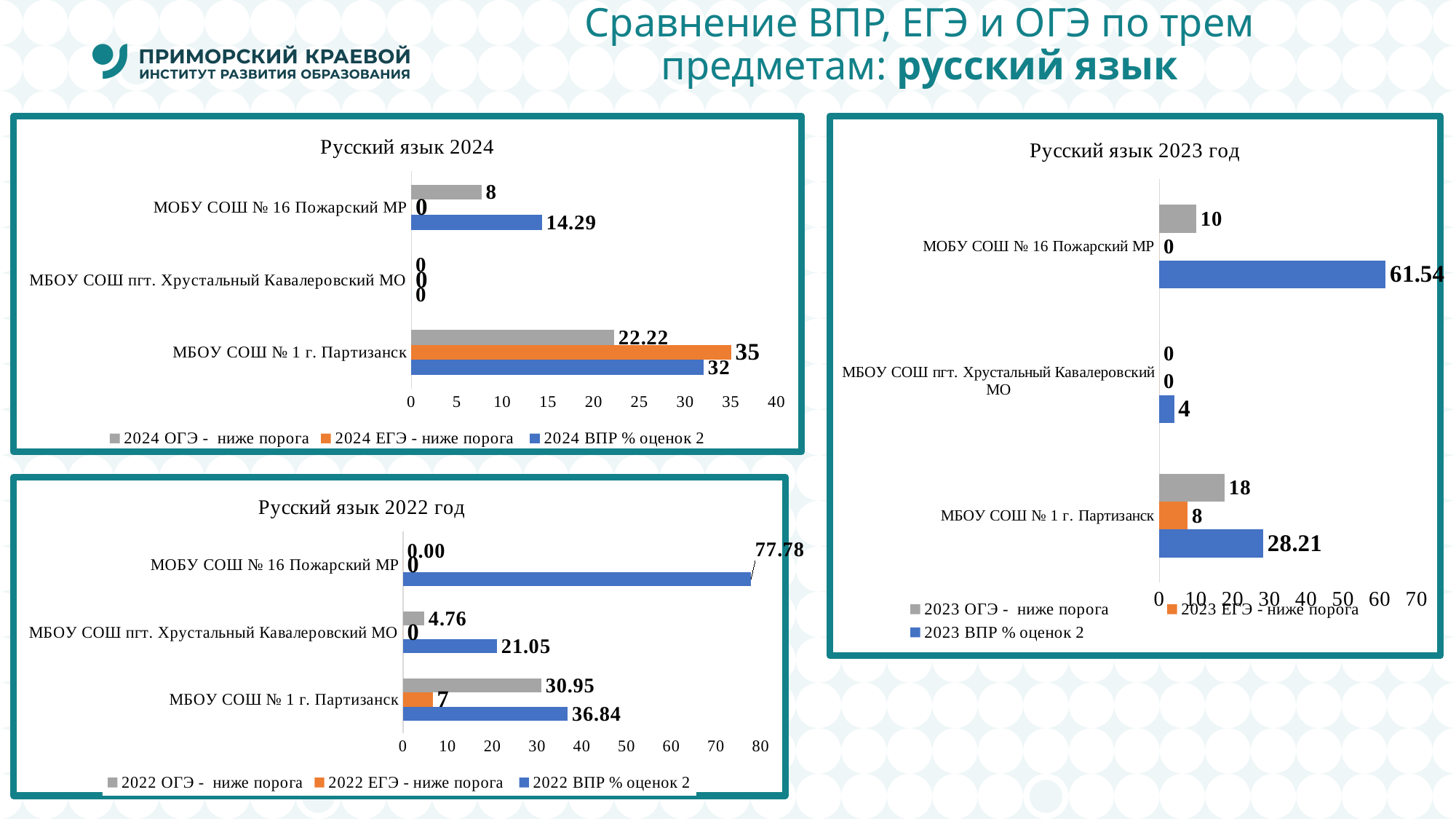
In the chart titled "Русский язык 2024", what is the value of "2024 ЕГЭ - ниже порога" for МБОУ СОШ № 1 г. Партизанск? 35 In the chart titled "Русский язык 2023 год", what is the value of "2023 ОГЭ - ниже порога" for МБОУ СОШ № 1 г. Партизанск? 18 In the chart titled "Русский язык 2022 год", what is the value of "2022 ОГЭ - ниже порога" for МБОУ СОШ пгт. Хрустальный Кавалеровский МО? 4.76 In the chart titled "Русский язык 2022 год", what is the value of "2022 ВПР % оценок 2" for МОБУ СОШ № 16 Пожарский МР? 77.78 In the chart titled "Русский язык 2024", which school has the highest value for "2024 ОГЭ - ниже порога"? МБОУ СОШ № 1 г. Партизанск What type of chart is the chart titled "Русский язык 2023 год"? Bar chart In the chart titled "Русский язык 2022 год", which is larger for МБОУ СОШ № 1 г. Партизанск: "2022 ОГЭ - ниже порога" or "2022 ВПР % оценок 2"? 2022 ВПР % оценок 2 How many series does the legend list in the chart titled "Русский язык 2022 год"? 3 In the chart titled "Русский язык 2023 год", what is the value of "2023 ВПР % оценок 2" for МОБУ СОШ № 16 Пожарский МР? 61.54 In the chart titled "Русский язык 2023 год", which school has the lowest value for "2023 ВПР % оценок 2"? МБОУ СОШ пгт. Хрустальный Кавалеровский МО In the chart titled "Русский язык 2024", what is the value of "2024 ВПР % оценок 2" for МОБУ СОШ № 16 Пожарский МР? 14.29 In the chart titled "Русский язык 2024", what is the difference between the "2024 ЕГЭ - ниже порога" and "2024 ВПР % оценок 2" values for МБОУ СОШ № 1 г. Партизанск? 3